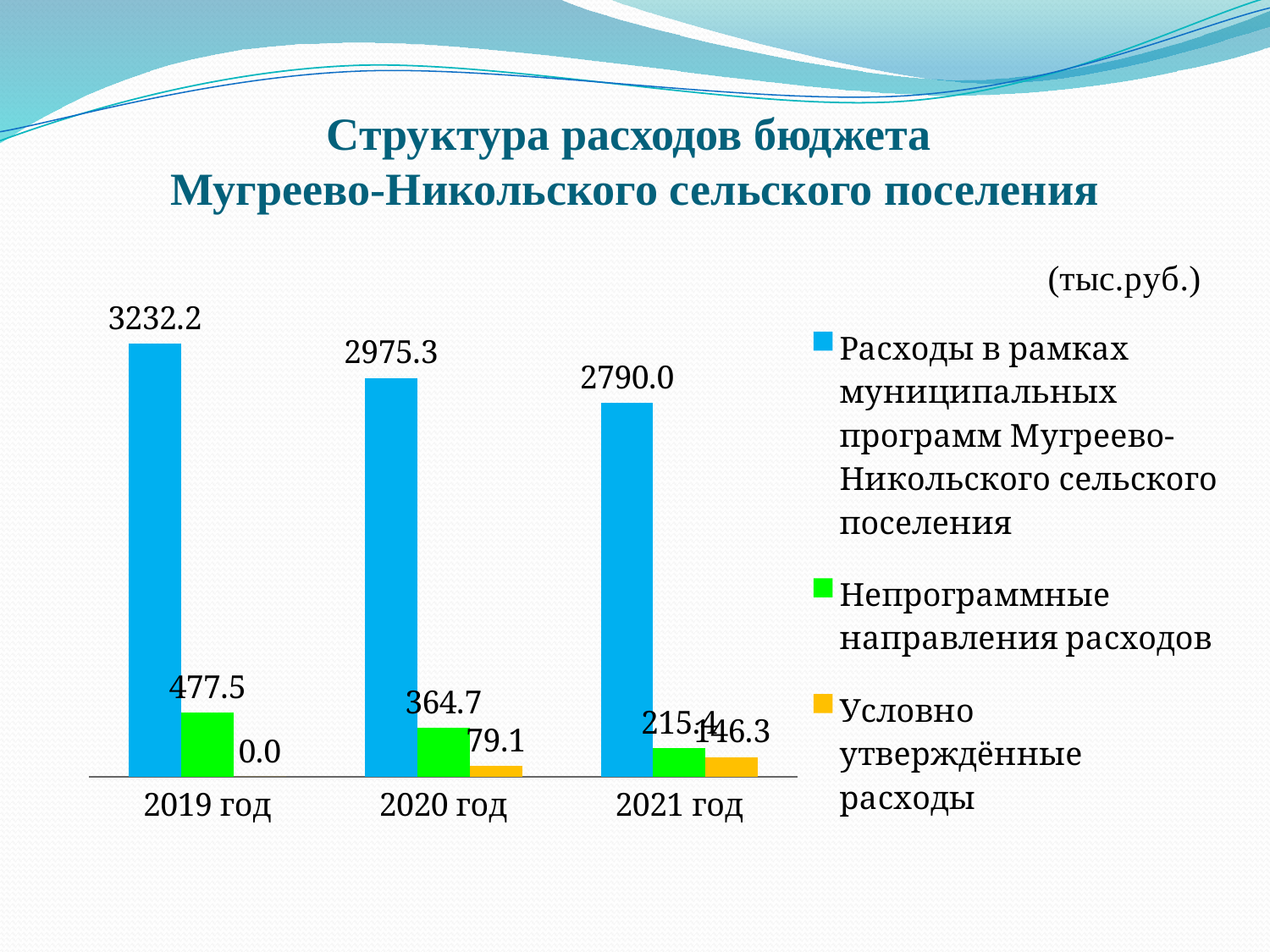
What is the value of 'Расходы в рамках муниципальных программ Мугреево-Никольского сельского поселения' for 2019 год? 3232.2 What is the value of 'Расходы в рамках муниципальных программ Мугреево-Никольского сельского поселения' for 2021 год? 2790.0 In which year is 'Расходы в рамках муниципальных программ Мугреево-Никольского сельского поселения' highest? 2019 год How many year categories are shown on the x axis? 3 Which is larger in 2020 год: 'Непрограммные направления расходов' or 'Условно утверждённые расходы'? Непрограммные направления расходов What type of chart is shown on the slide? bar chart What is the difference between the 'Расходы в рамках муниципальных программ' values for 2019 год and 2020 год? 256.9 Does 'Условно утверждённые расходы' rise or fall from 2019 год to 2021 год? rise How many series does the legend list? 3 What is the value of 'Непрограммные направления расходов' for 2020 год? 364.7 What is the value of 'Условно утверждённые расходы' for 2019 год? 0.0 What is the value of 'Условно утверждённые расходы' for 2021 год? 146.3